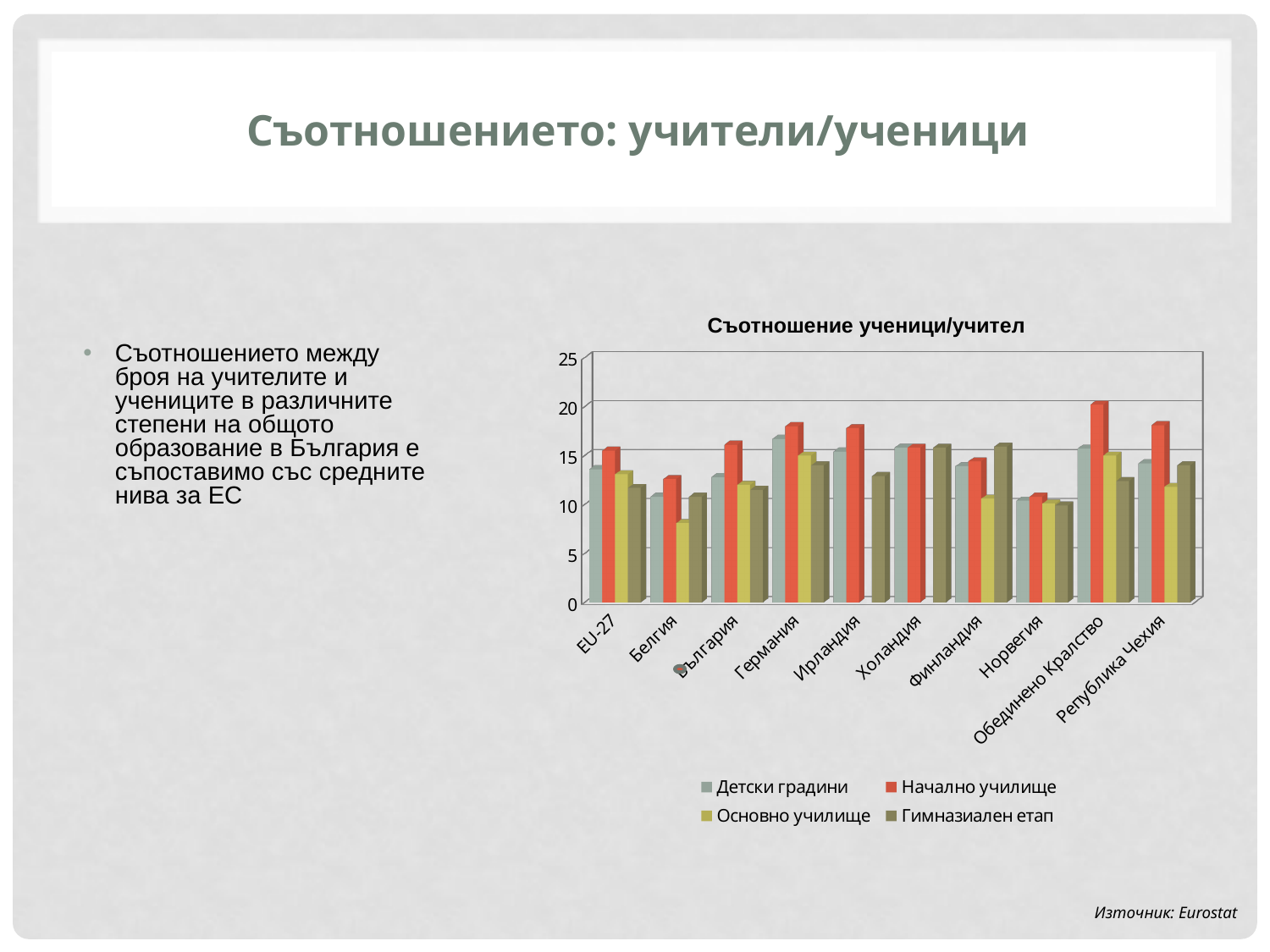
What is the title of the chart? Съотношение ученици/учител How many countries/categories are shown on the x axis of the chart? 10 Is the value for Основно училище in Белгия greater or less than 10? less Is the value for Начално училище in Германия greater or less than 15? greater How many series does the chart legend list? 4 What kind of chart is shown on the slide? bar chart Which series is shown in red in the chart? Начално училище Is the value for Гимназиален етап in Обединено Кралство greater or less than 15? less Which is larger: the Начално училище value for Германия or for Белгия? Германия Which country has the lowest value for Основно училище? Белгия Which country has the highest value for Начално училище? Обединено Кралство